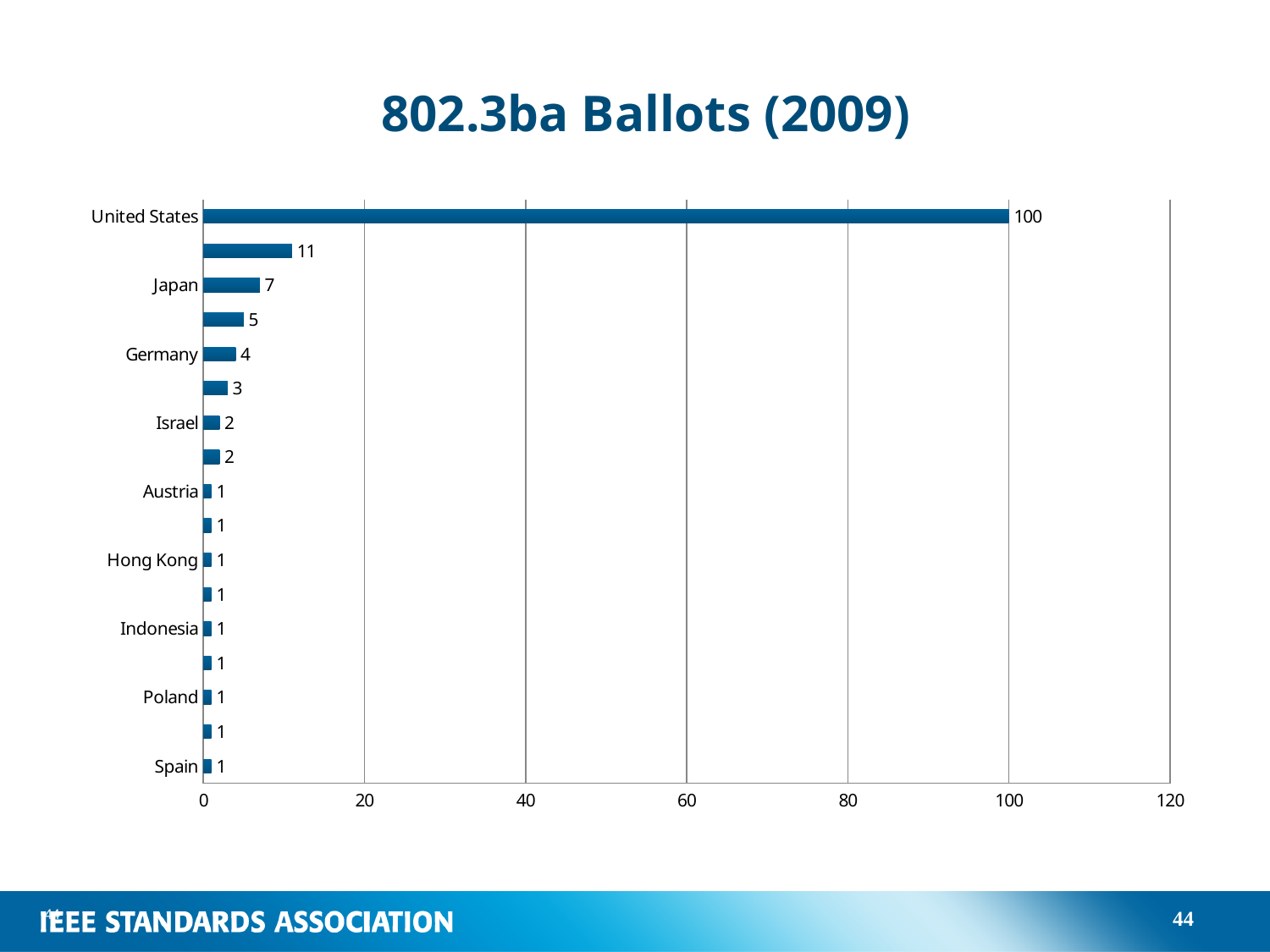
What is the value for Spain? 1 Which category has the highest value? United States Which is larger, the value for Japan or the value for Germany? Japan Is the value for United States greater or less than 80? greater What is the value for Israel? 2 What is the value for United States? 100 How many bars are plotted in the chart? 17 What is the title of the chart? 802.3ba Ballots (2009) What is the value for Germany? 4 What is the difference between the values for United States and Japan? 93 What is the value for Japan? 7 What kind of chart is shown on the slide? Bar chart